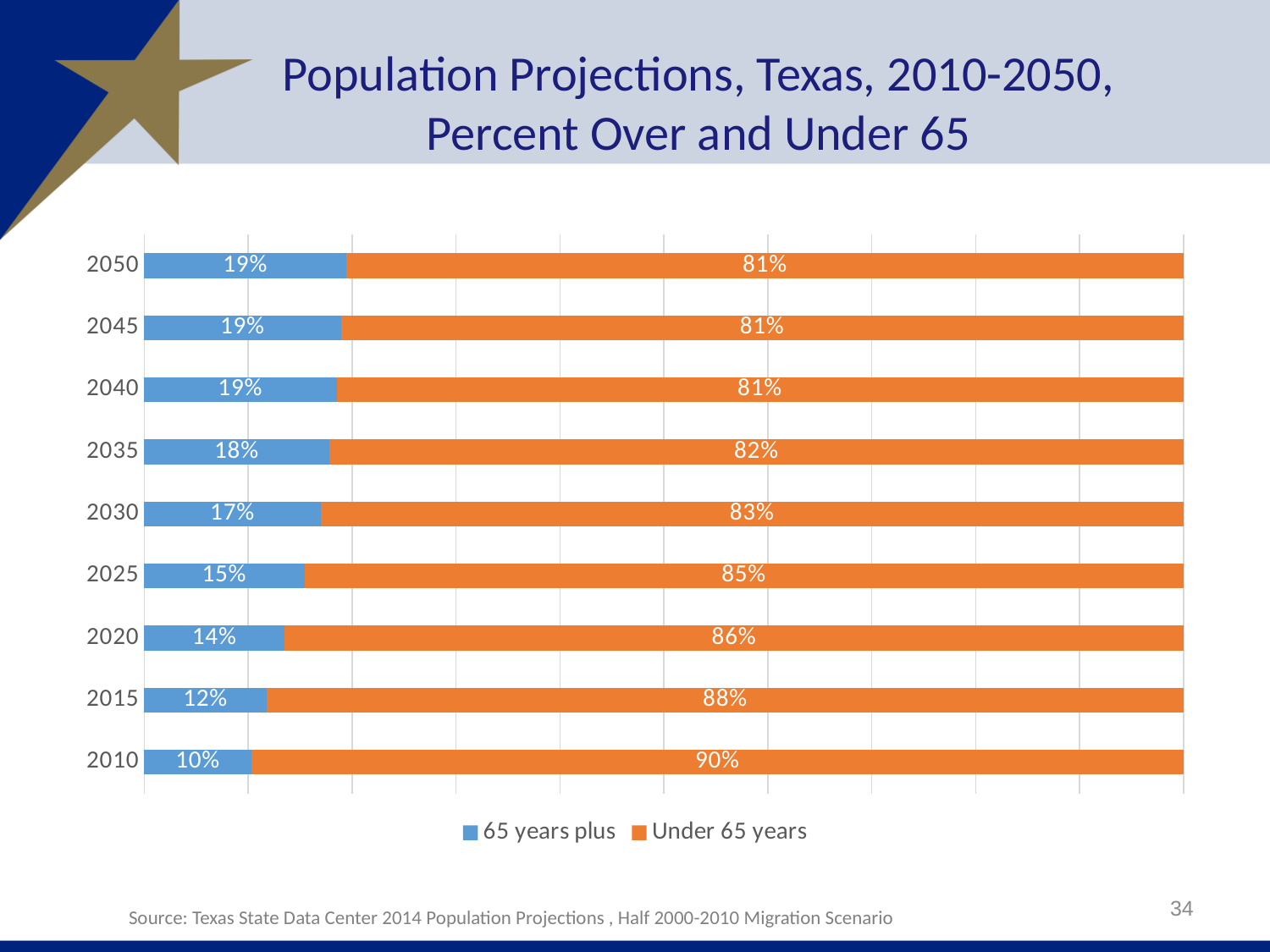
What is the value for Under 65 years in 2030? 83% What is the value for 65 years plus in 2025? 15% What kind of chart is shown on the slide? Stacked bar chart What is the difference between the 65 years plus values for 2050 and 2010? 9% What is the total of the stacked bar for 2040? 100% Which year has the lowest value for 65 years plus? 2010 Which year has the highest value for Under 65 years? 2010 Which is larger, the 65 years plus value for 2020 or for 2035? 2035 How many years are shown on the chart? 9 How many series does the legend list? 2 Does the 65 years plus share rise or fall from 2010 to 2050? Rise What is the value for 65 years plus in 2010? 10%